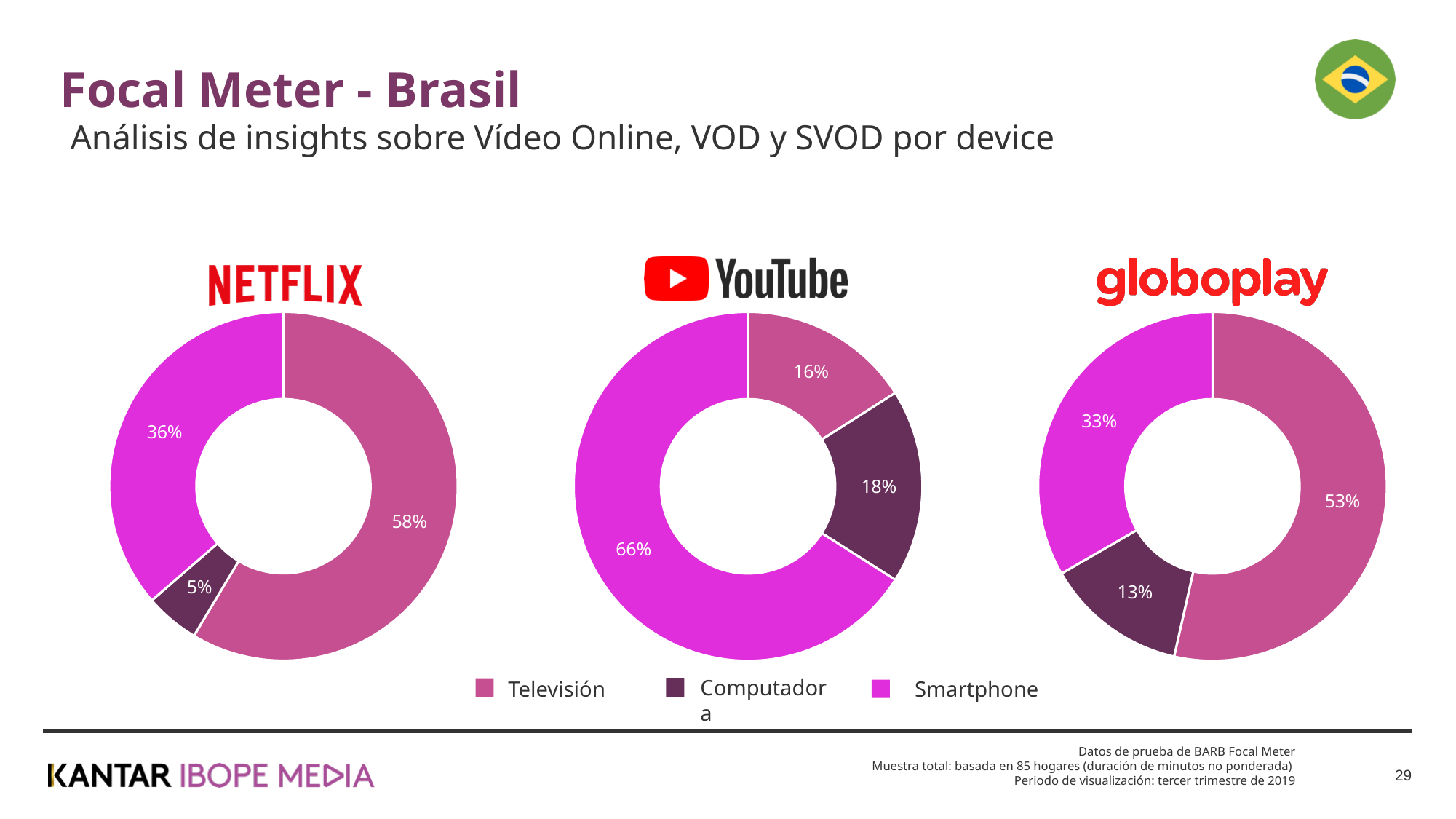
In the YouTube chart, which is larger, Televisión or Computadora? Computadora In the Netflix chart, which device has the smallest share? Computadora What kind of chart is used for each platform on this slide? Donut (pie) chart In the globoplay chart, what share is Computadora? 13% In the globoplay chart, which device has the largest share? Televisión In the YouTube chart, what share is Smartphone? 66% How many series does the legend list? 3 In the Netflix chart, what share is Televisión? 58% In the Netflix chart, what is the difference between the Televisión and Smartphone shares? 22% In the globoplay chart, what is the difference between the Smartphone and Computadora shares? 20% In the YouTube chart, which device has the largest share? Smartphone How many donut charts are shown on the slide? 3